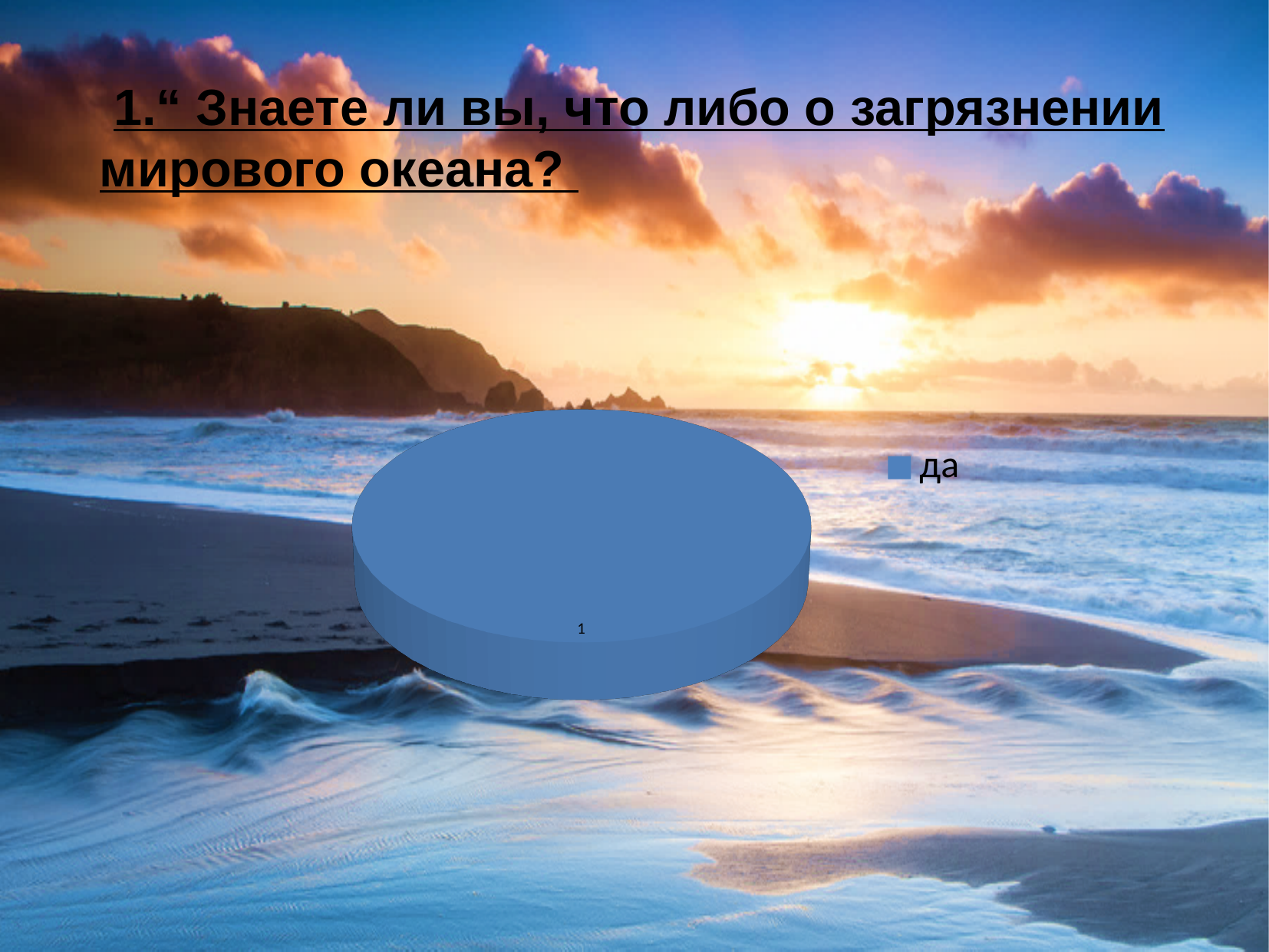
What is the only category named in the legend of the pie chart? да What is the data label printed on the pie slice? 1 What colour is the "да" slice in the pie chart? blue What is the value shown for the category "да" in the pie chart? 1 What share of the pie does the "да" slice take up? 100% How many slices does the pie chart have? 1 How many entries does the legend of the pie chart list? 1 What kind of chart is shown on the slide? pie chart